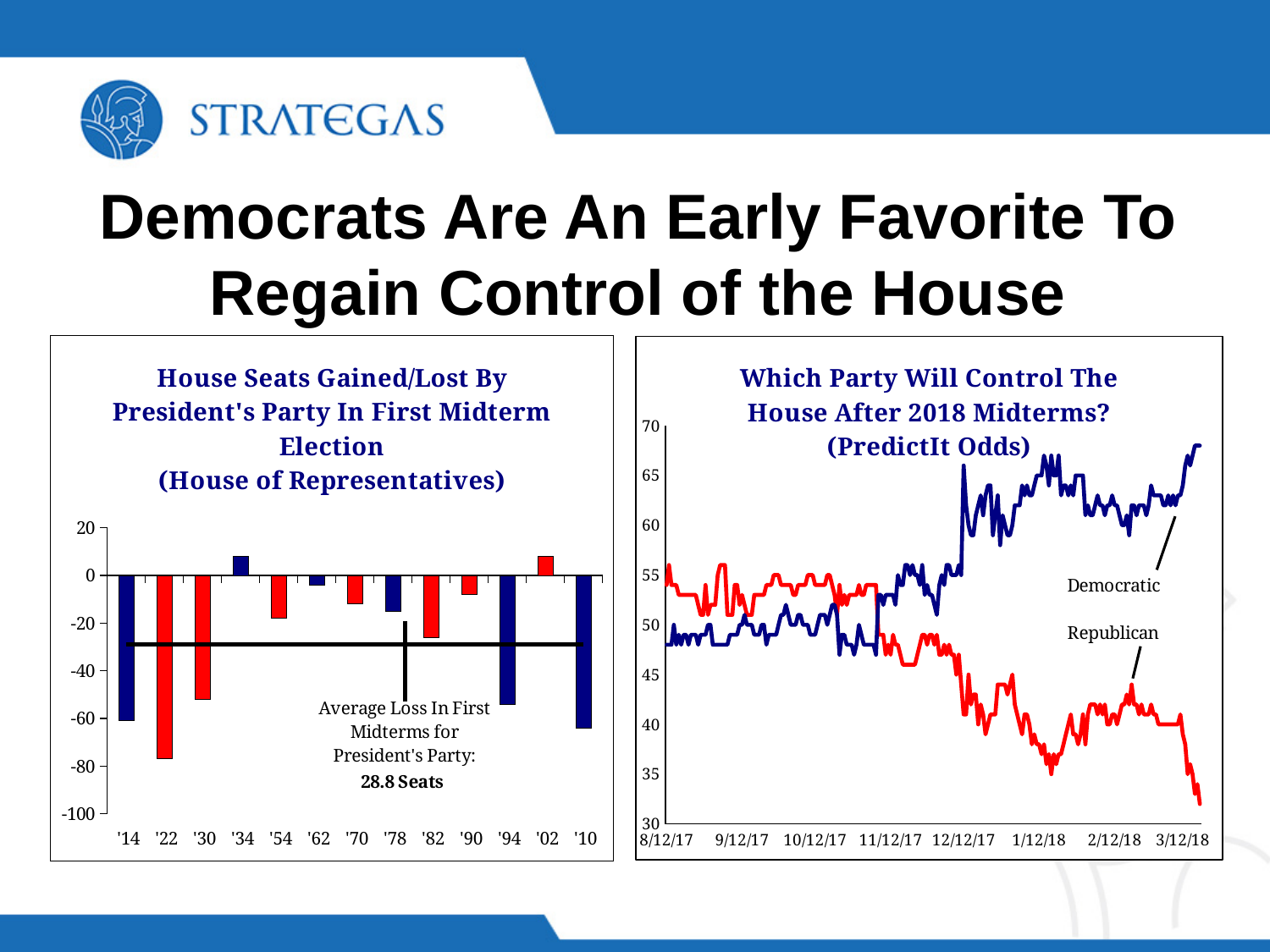
What kind of chart is the left chart, 'House Seats Gained/Lost By President's Party In First Midterm Election'? bar chart In the right chart, does the Democratic line generally rise or fall from 8/12/17 to 3/12/18? rise What kind of chart is the right chart, 'Which Party Will Control The House After 2018 Midterms?'? line chart In the right chart, how many series (parties) are plotted? 2 In the left chart, is the value for '82 greater or less than -20? less In the left chart, which year shows a larger loss of seats, '22 or '30? '22 In the right chart, is the Republican value at 3/12/18 greater or less than 35? greater In the left chart, is the value for '14 greater or less than -40? less In the left chart, what is the stated average loss in first midterms for the President's party? 28.8 Seats In the left chart, how many election years are shown on the x axis? 13 In the left chart, which election year shows the largest loss of seats (the lowest bar)? '22